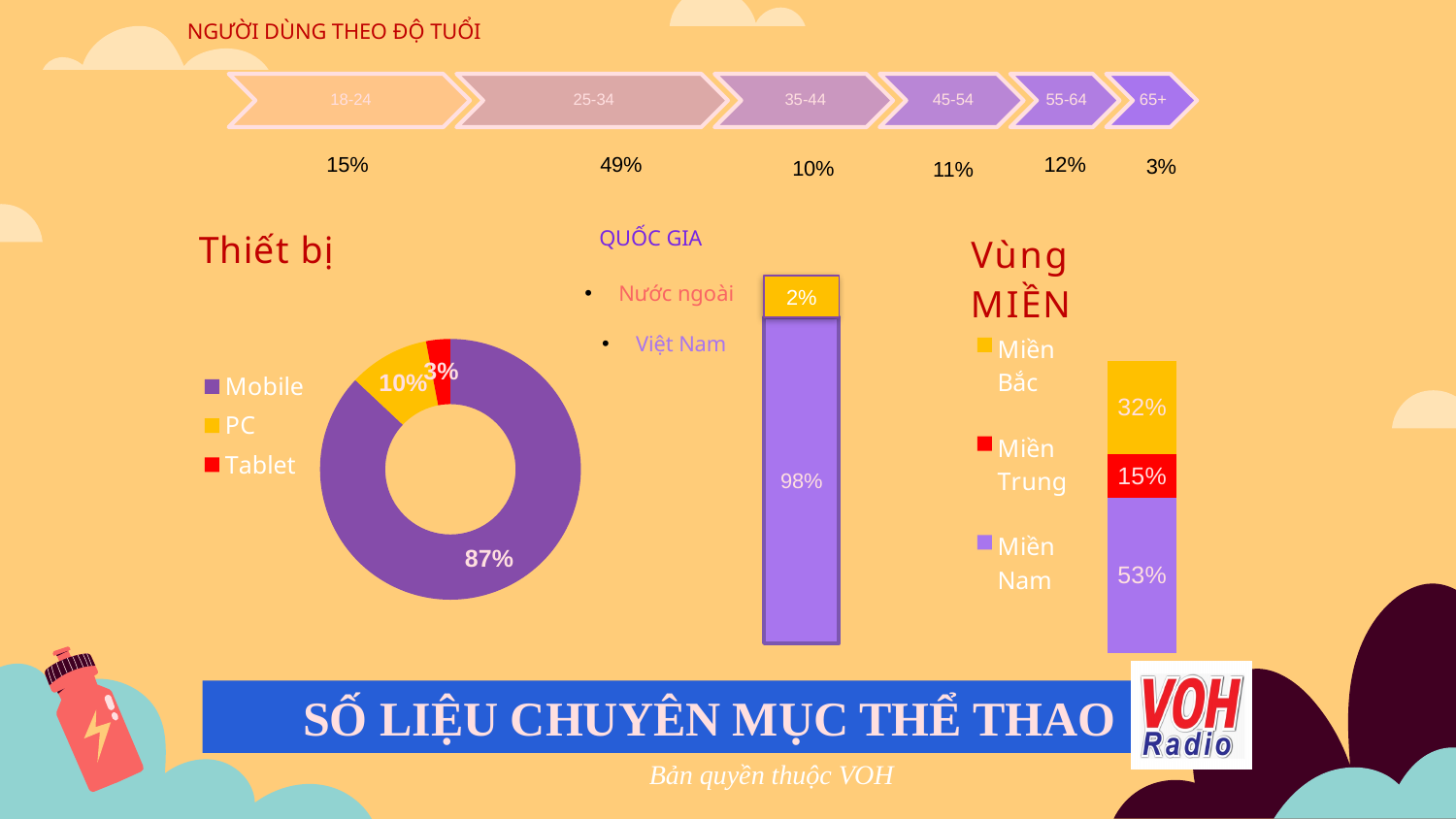
What kind of chart is the "Thiết bị" chart? Donut chart In the "Vùng MIỀN" chart, what is the value for Miền Bắc? 32% In the "Vùng MIỀN" chart, what is the difference between Miền Nam and Miền Trung? 38% In the "QUỐC GIA" chart, what is the difference between Việt Nam and Nước ngoài? 96% In the "Vùng MIỀN" chart, which is larger, Miền Bắc or Miền Trung? Miền Bắc In the "QUỐC GIA" chart, what is the value for Việt Nam? 98% In the "QUỐC GIA" chart, what is the value for Nước ngoài? 2% In the "Vùng MIỀN" chart, which region has the largest share? Miền Nam In the "Thiết bị" chart, what is the value for PC? 10% In the "Thiết bị" chart, what share does Mobile have? 87% In the "Thiết bị" chart, which category has the smallest share? Tablet How many categories does the legend of the "Thiết bị" chart list? 3